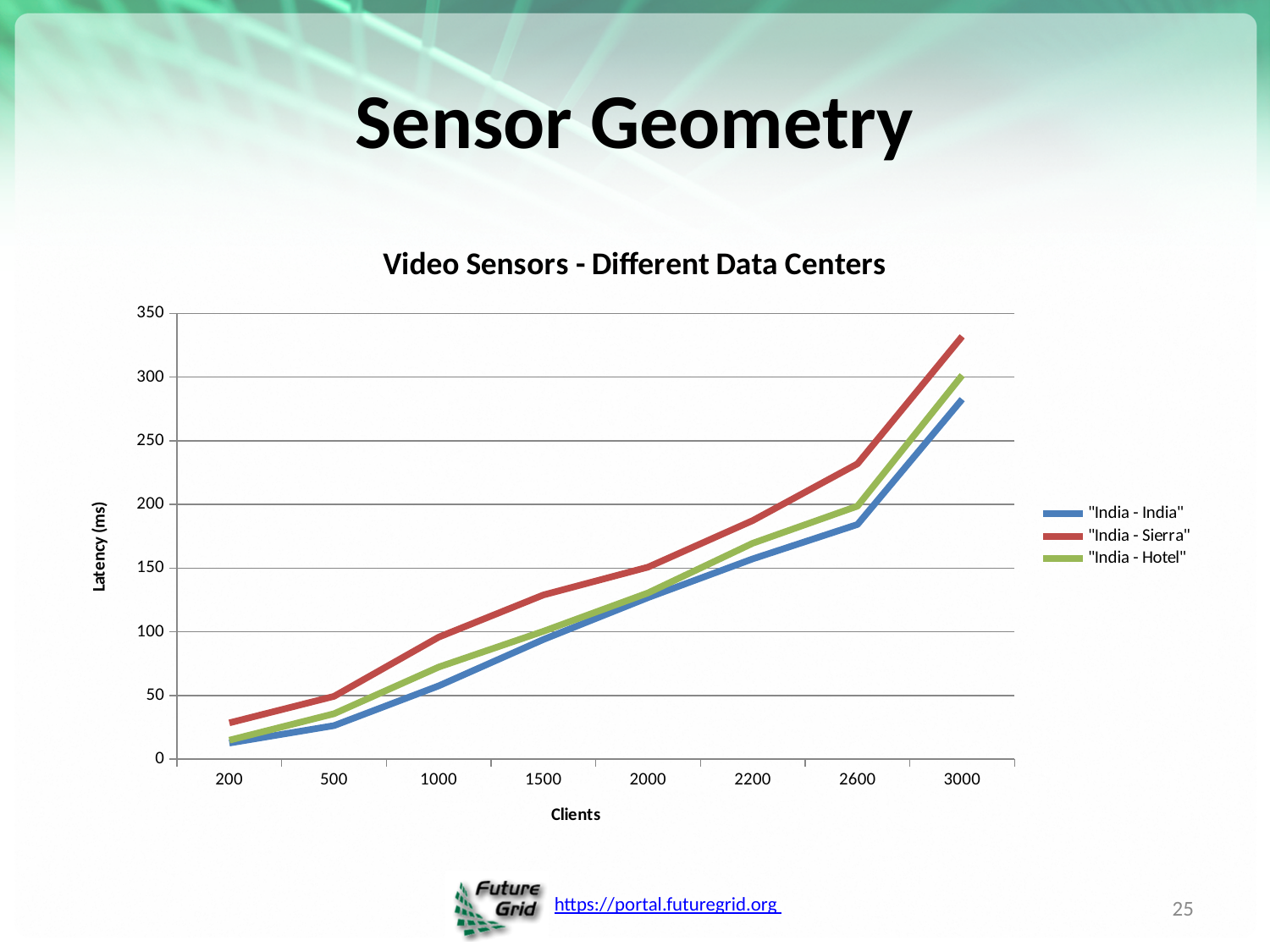
Which series has the highest latency at 3000 clients? "India - Sierra" What kind of chart is shown on the slide? line chart Which series has the lowest latency at 3000 clients? "India - India" Is the latency for "India - Sierra" at 3000 clients greater or less than 300? greater How many client values are plotted along the x axis? 8 What is the title of the chart? Video Sensors - Different Data Centers Is the latency for "India - Sierra" at 1500 clients greater or less than 100? greater Is the latency for "India - India" at 2600 clients greater or less than 200? less Does the latency for "India - Sierra" rise or fall as the number of clients increases? rise How many series does the legend list? 3 At 500 clients, which has the higher latency, "India - Sierra" or "India - India"? "India - Sierra" What is the label of the y axis? Latency (ms)